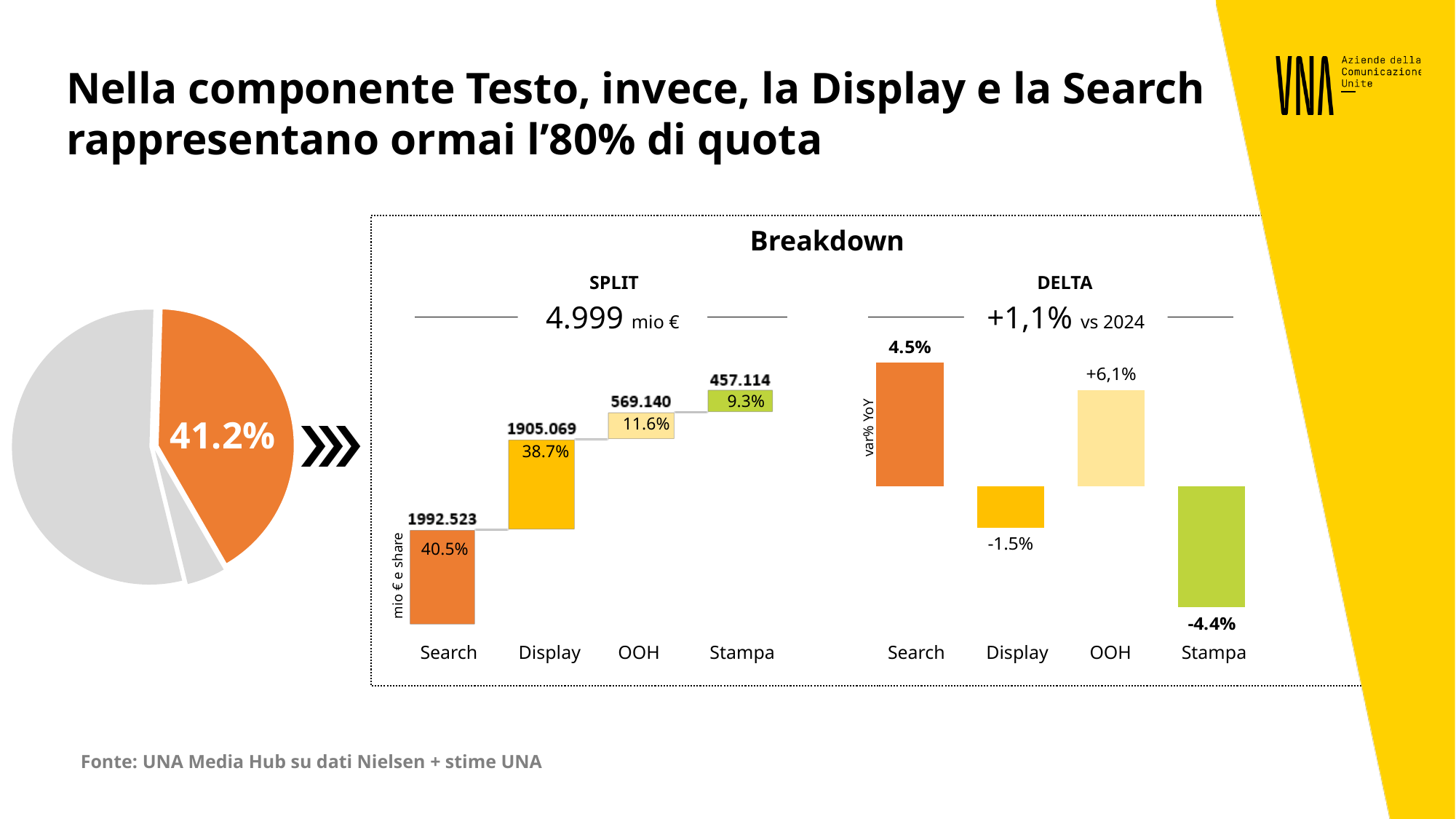
In the SPLIT chart, which category has the lowest value? Stampa In the SPLIT chart, what share is shown for Display? 38.7% What kind of chart is the DELTA chart? bar chart In the SPLIT chart, what is the difference between the values for OOH and Stampa? 112.026 In the SPLIT chart, which category has the highest value? Search In the SPLIT chart, what total is shown above the bars? 4.999 mio € In the DELTA chart, how many categories are shown? 4 In the SPLIT chart, what is the value shown for Search? 1992.523 In the DELTA chart, which category has the lowest value? Stampa In the DELTA chart, what is the value shown for OOH? +6,1% In the pie chart on the left, what share is shown for the orange slice? 41.2%